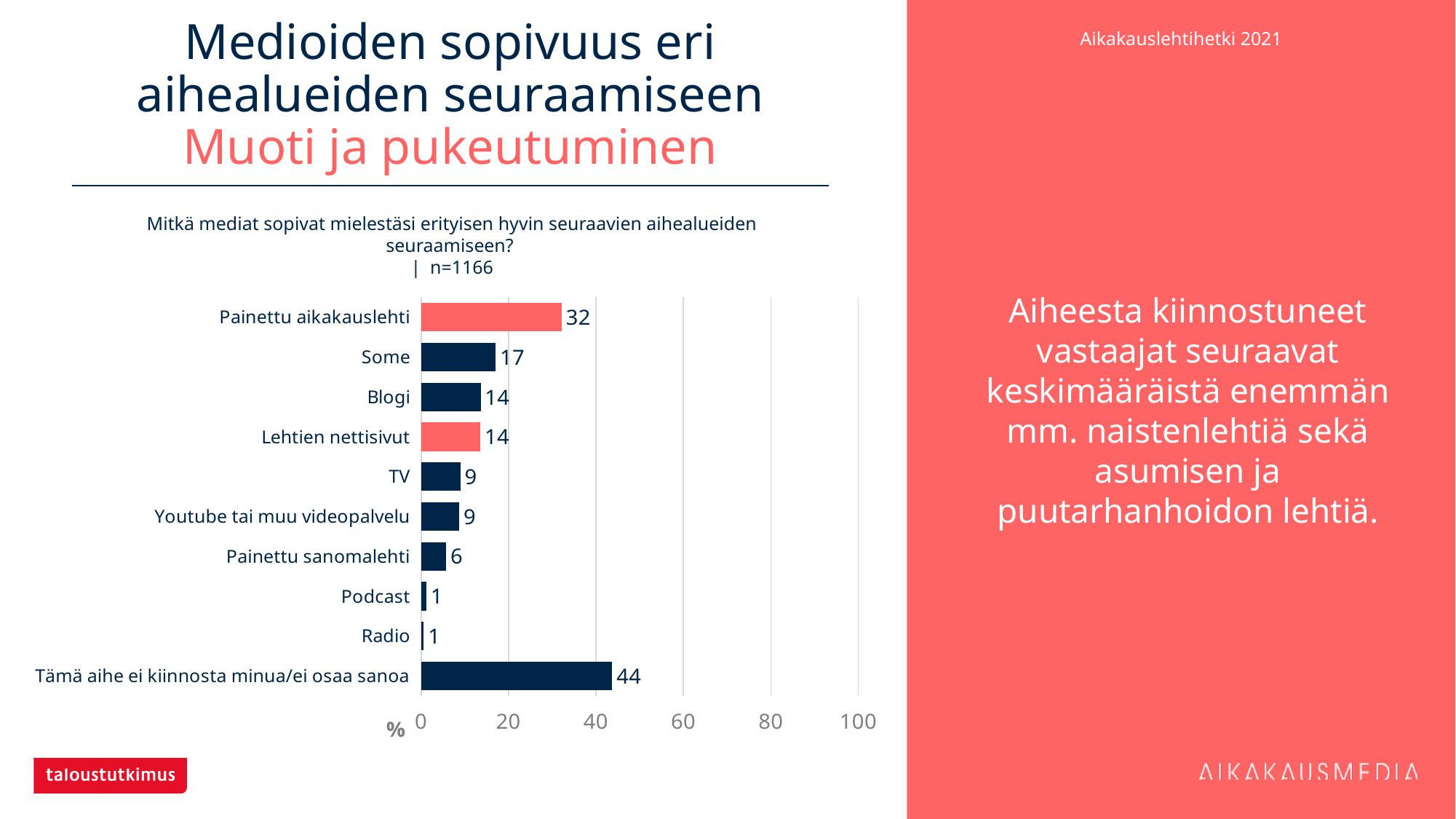
Is the value for Tämä aihe ei kiinnosta minua/ei osaa sanoa greater or less than 40? greater What is the value for Painettu sanomalehti? 6 What is the value for Painettu aikakauslehti? 32 Which is larger, the value for Blogi or the value for TV? Blogi What is the value for Some? 17 How many categories are shown in the chart? 10 What kind of chart is shown on the slide? bar chart What is the sample size (n) stated above the chart? n=1166 Which category has the lowest value among the media options, excluding Radio? Podcast Which category has the highest value? Tämä aihe ei kiinnosta minua/ei osaa sanoa What is the difference between the values for Painettu aikakauslehti and Some? 15 What is the value for Lehtien nettisivut? 14